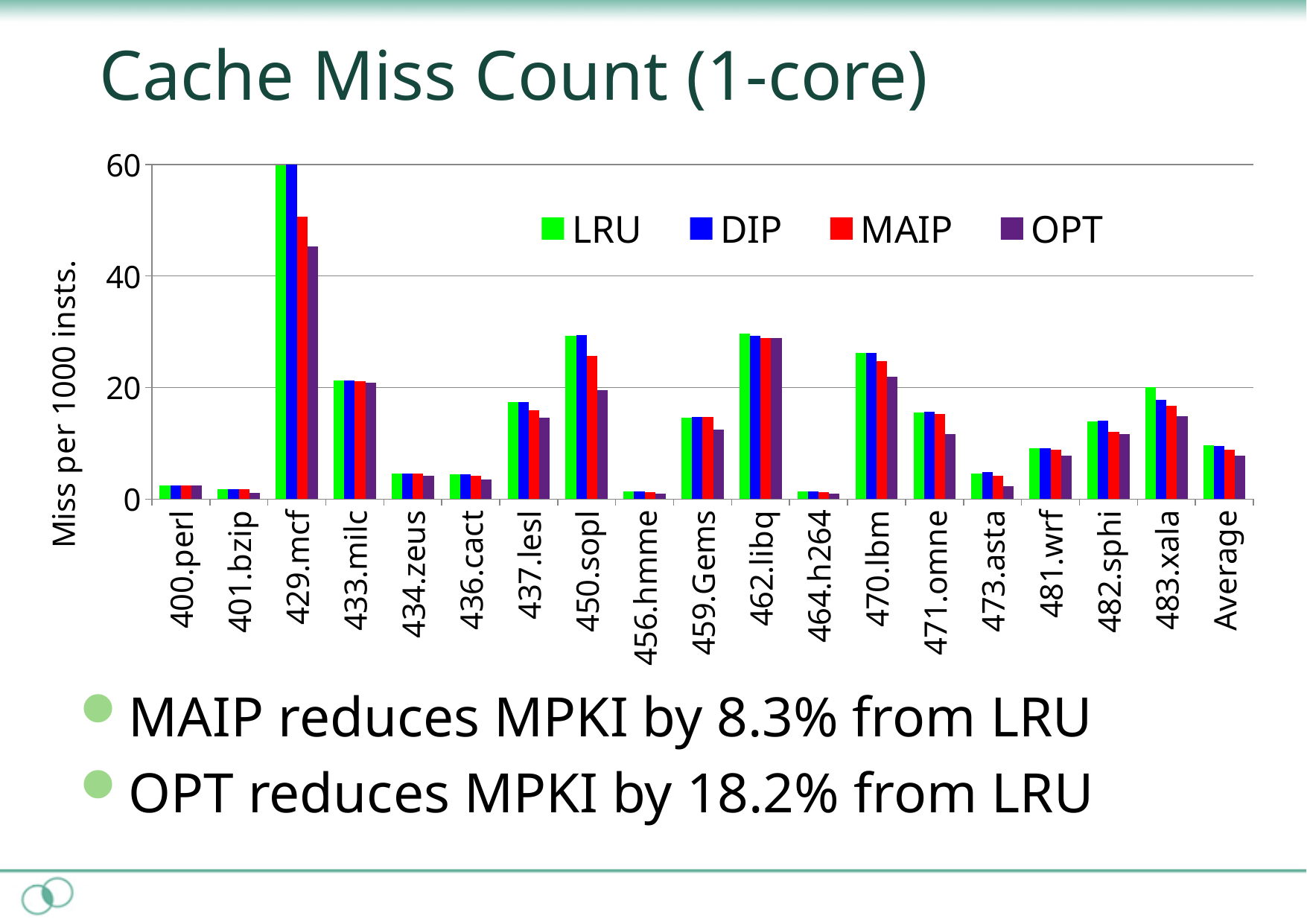
Is the LRU value for 429.mcf greater or less than 40? greater Is the OPT value for 437.lesl greater or less than 20? less Which has the larger LRU value, 462.libq or 459.Gems? 462.libq How many categories are shown along the x axis? 19 For 470.lbm, which is larger, the LRU value or the OPT value? LRU What is the label of the y axis? Miss per 1000 insts. How many series does the legend list? 4 What kind of chart is shown on the slide? bar chart Is the LRU value for 459.Gems greater or less than 20? less Which category has the highest miss count? 429.mcf